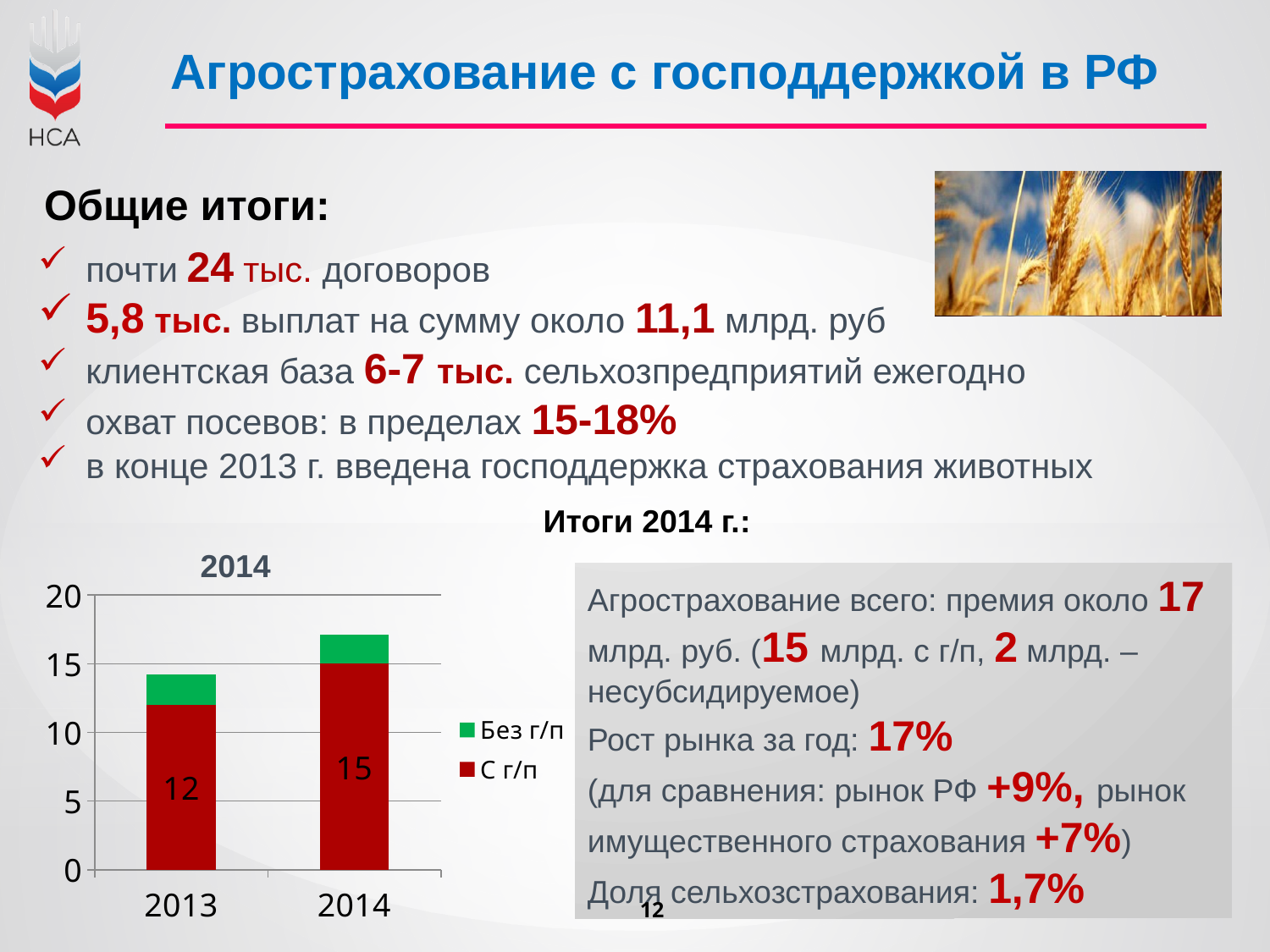
What is the value of the "С г/п" series for 2013? 12 Is the total height of the 2014 bar greater or less than 20? less Is the total height of the 2013 bar greater or less than 10? greater What is the difference between the "С г/п" values for 2014 and 2013? 3 Is the "С г/п" value for 2014 larger or smaller than the "С г/п" value for 2013? larger How many series does the chart legend list? 2 Which year has the higher value for the "С г/п" series? 2014 What is the value of the "С г/п" series for 2014? 15 How many categories (years) are shown on the x axis of the chart? 2 Does the "С г/п" value rise or fall from 2013 to 2014? rise What type of chart is shown on the slide? stacked bar chart Which year has the lower value for the "С г/п" series? 2013